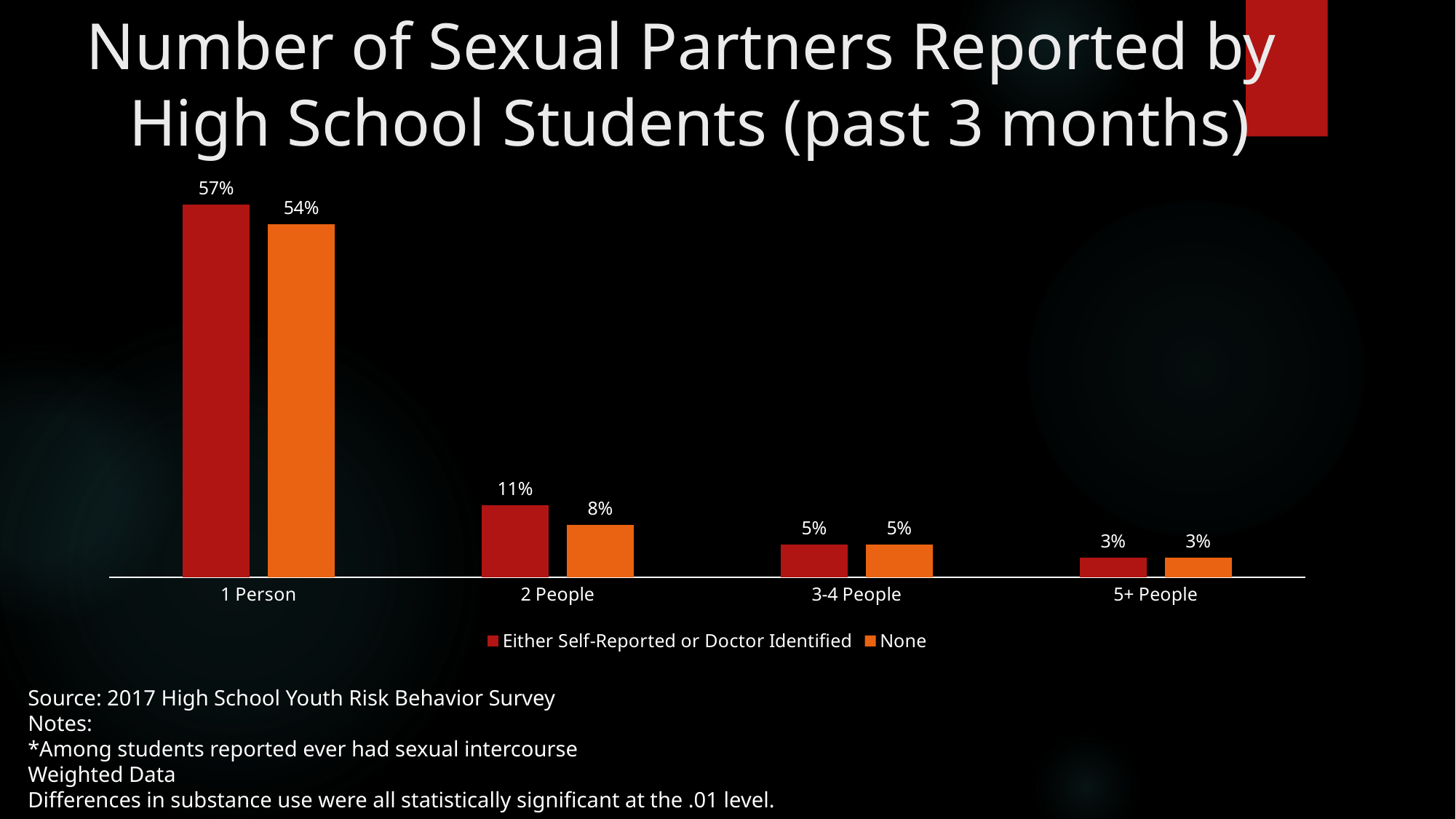
Which category has the lowest value for the 'None' series? 5+ People Do the values for the 'None' series rise or fall from 1 Person to 5+ People? Fall Which category has the highest value for the 'Either Self-Reported or Doctor Identified' series? 1 Person What is the difference between the two series for 2 People? 3% What kind of chart is shown on the slide? Bar chart What is the value for 5+ People in the 'None' series? 3% For 2 People, which series has the larger value? Either Self-Reported or Doctor Identified What is the difference between the 'Either Self-Reported or Doctor Identified' and 'None' values for 1 Person? 3% How many series does the legend list? 2 What percentage of students in the 'None' group reported 2 People? 8% What percentage of students in the 'Either Self-Reported or Doctor Identified' group reported 1 Person? 57% How many categories are shown on the x axis? 4